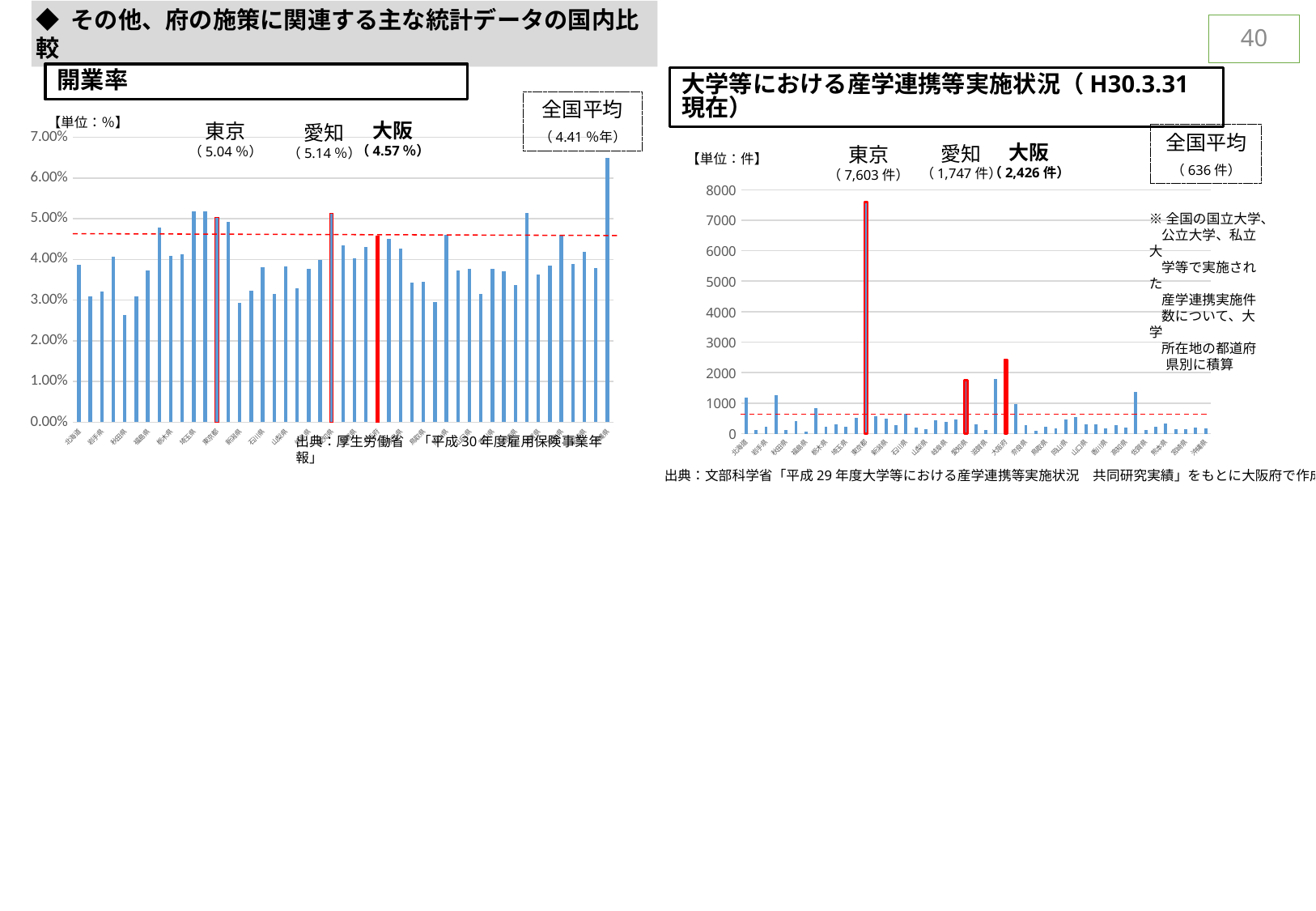
In the 開業率 chart, what is the value for 大阪? 4.57% In the 開業率 chart, what is the value for 東京? 5.04% In the 開業率 chart, is the value for 大阪 greater or less than the 全国平均? greater In the 大学等における産学連携等実施状況 chart, what is the difference between the values for 東京 and 大阪? 5,177件 In the 大学等における産学連携等実施状況 chart, what is the value for 愛知? 1,747件 In the 大学等における産学連携等実施状況 chart, what is the value for 東京? 7,603件 In the 開業率 chart, what is the difference between the values for 愛知 and 東京? 0.10% In the 大学等における産学連携等実施状況 chart, which prefecture has the highest value? 東京 In the 大学等における産学連携等実施状況 chart, what is the 全国平均? 636件 In the 開業率 chart, which is larger, the value for 愛知 or the value for 東京? 愛知 In the 開業率 chart, what is the 全国平均 (national average)? 4.41% What kind of chart is the 大学等における産学連携等実施状況 chart? bar chart